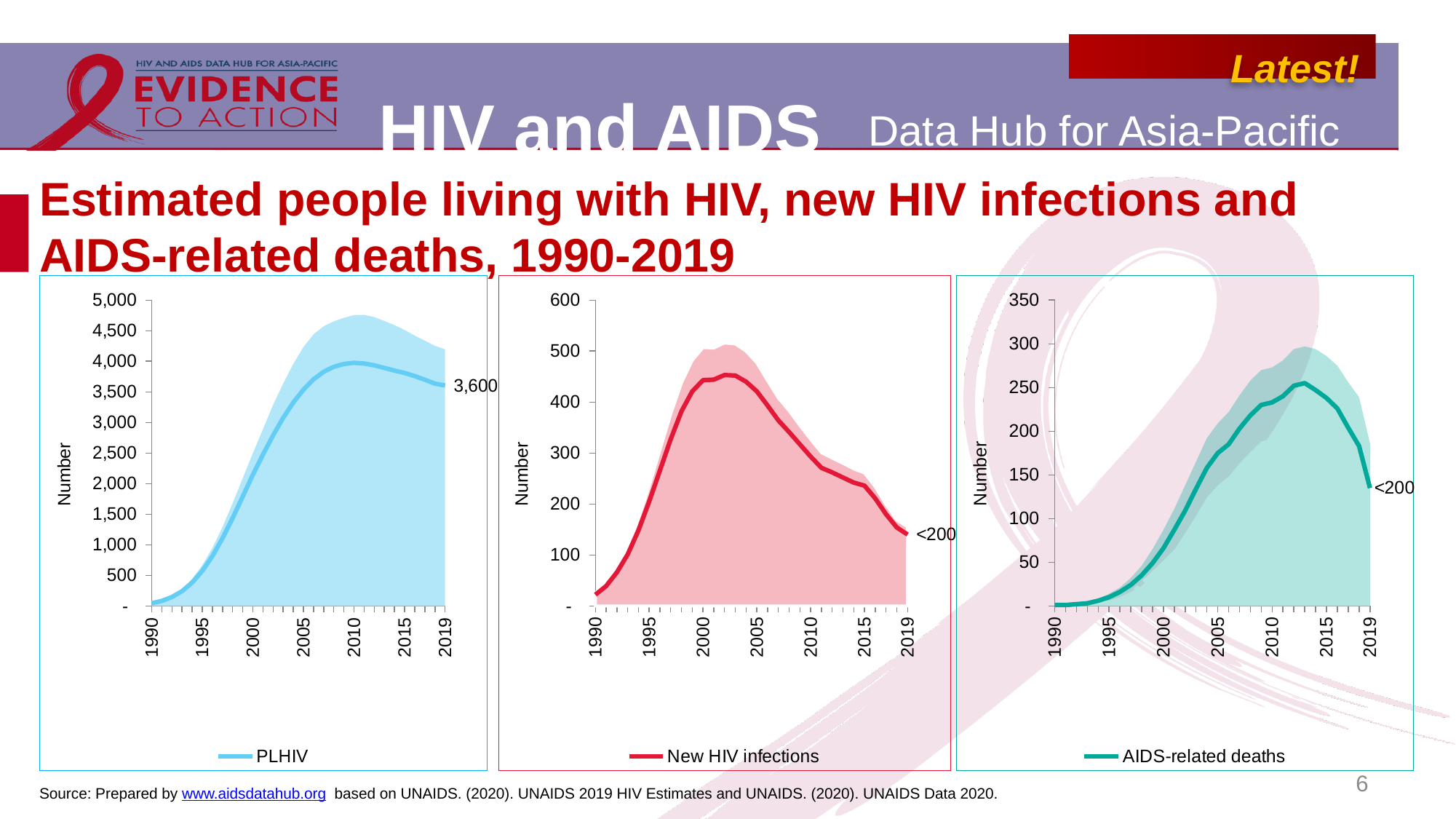
In the right chart (AIDS-related deaths), is the value for 2010 greater or less than 200? greater What type of chart is the left chart (PLHIV)? area and line chart (a line with a shaded area band) In the right chart (AIDS-related deaths), is the value for 2005 greater or less than 200? less How many series does the legend of the right chart list? 1 In the middle chart (New HIV infections), is the value for 2000 greater or less than 400? greater In the left chart (PLHIV), do the values rise or fall between 1990 and 2005? rise In the left chart (PLHIV), what is the data label shown for 2019? 3,600 In the right chart (AIDS-related deaths), what is the data label shown for 2019? <200 In the middle chart (New HIV infections), do the values rise or fall between 2005 and 2019? fall In the middle chart (New HIV infections), what is the data label shown for 2019? <200 What is the legend entry of the middle chart? New HIV infections